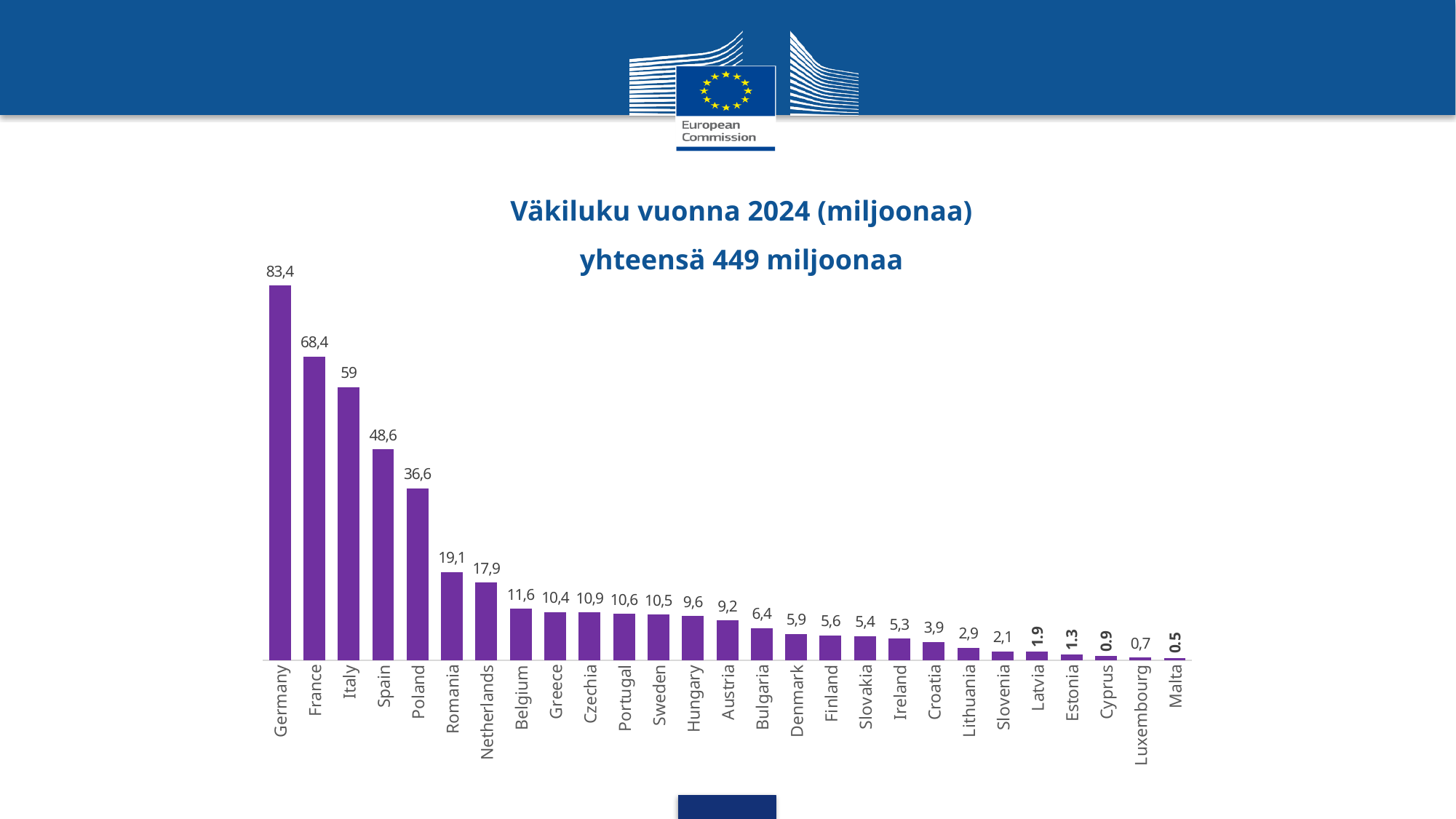
What is the value shown for Malta? 0.5 What kind of chart is shown on the slide? Bar chart Which country has the lowest value in the chart? Malta Which country has the highest value in the chart? Germany How many countries are shown in the chart? 27 What is the value shown for Czechia? 10,9 What is the difference between the values for Italy and Spain? 10,4 Which has a larger value, Romania or Netherlands? Romania What is the value shown for Germany? 83,4 What is the difference between the values for Germany and France? 15 What total is stated in the chart title? 449 miljoonaa What is the value shown for Poland? 36,6